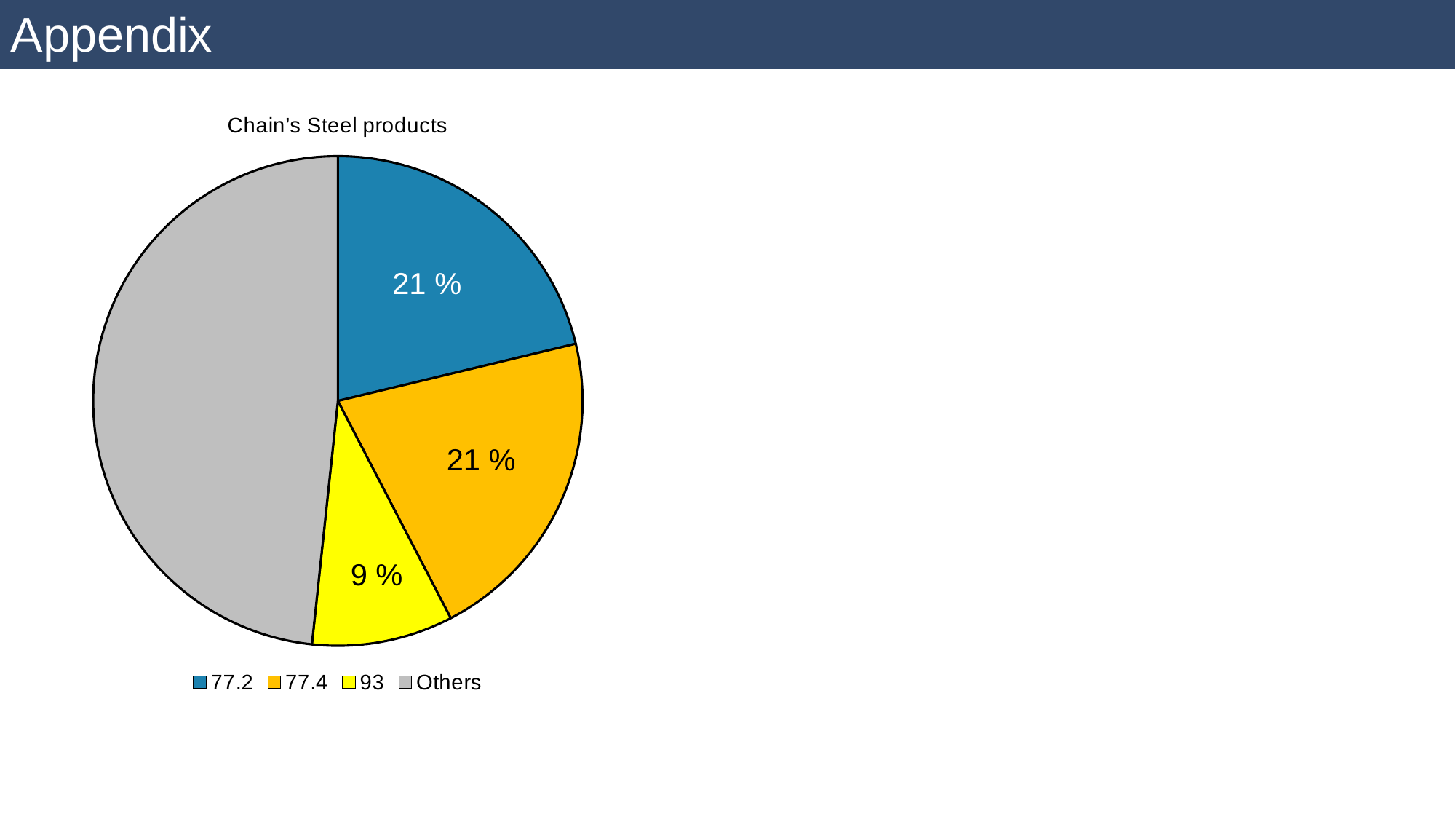
What colour is the slice for Others? Grey What is the difference in percentage points between the 77.2 slice and the 93 slice? 12 Which slice is larger, 77.4 or 93? 77.4 What share of the pie does the 77.4 slice represent? 21 % What is the title of the chart? Chain's Steel products What type of chart is shown on the slide? Pie chart What share of the pie does the 93 slice represent? 9 % How many entries does the legend list? 4 What share of the pie does the 77.2 slice represent? 21 % Which slice of the pie is the largest? Others Which slice of the pie is the smallest? 93 How many slices does the pie chart have? 4